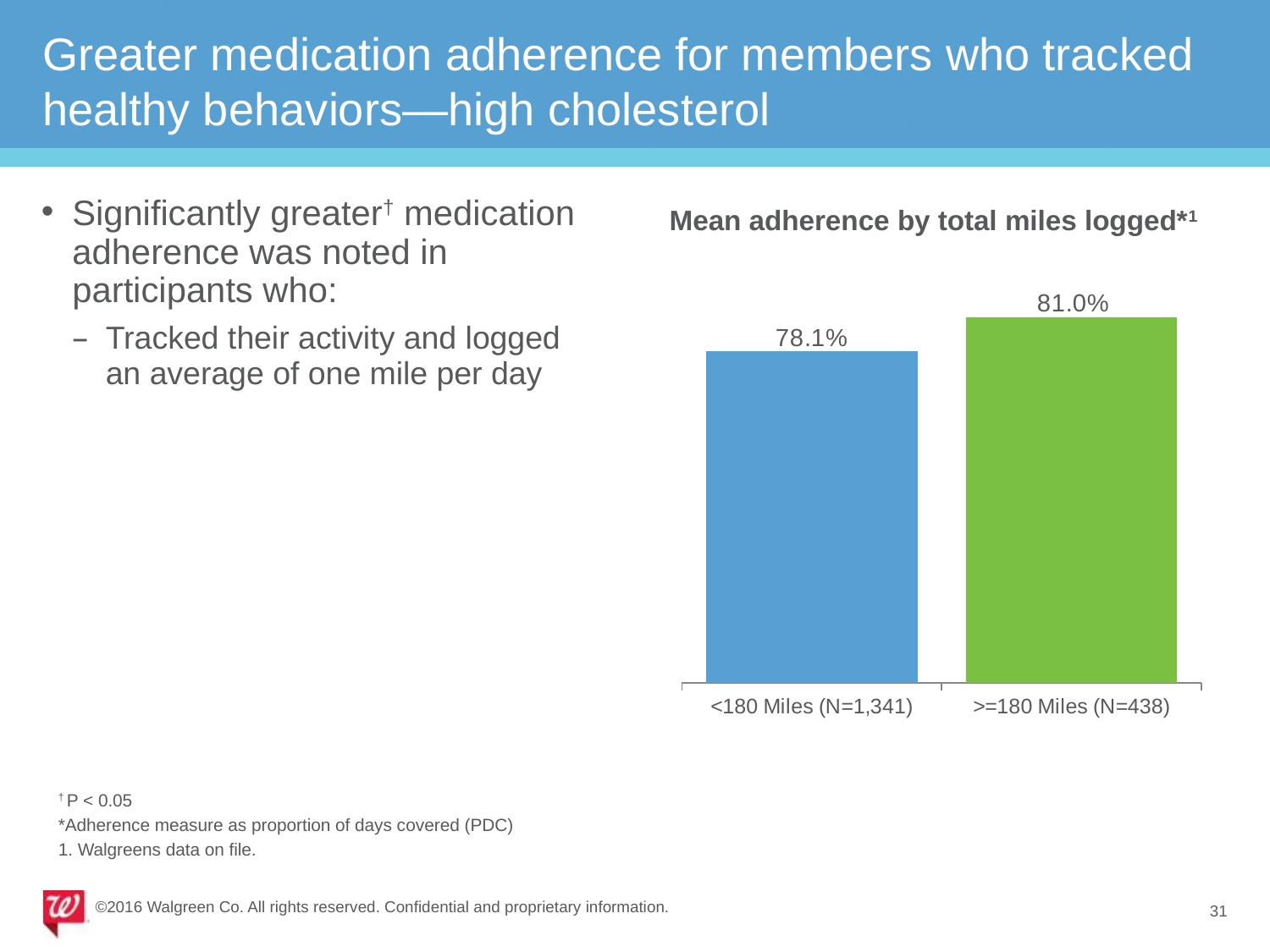
What is the difference in mean adherence between the >=180 Miles group and the <180 Miles group? 2.9% What is the title of the chart? Mean adherence by total miles logged*1 Which group has the lower mean adherence? <180 Miles (N=1,341) What kind of chart is shown on the slide? Bar chart Do the values rise or fall from the <180 Miles group to the >=180 Miles group? Rise Which group has the higher mean adherence? >=180 Miles (N=438) What is the mean adherence for the <180 Miles (N=1,341) group? 78.1% Is the mean adherence higher for the <180 Miles group or the >=180 Miles group? >=180 Miles group What colour is the bar for the >=180 Miles (N=438) group? Green How many categories are shown in the chart? 2 What is the mean adherence for the >=180 Miles (N=438) group? 81.0%